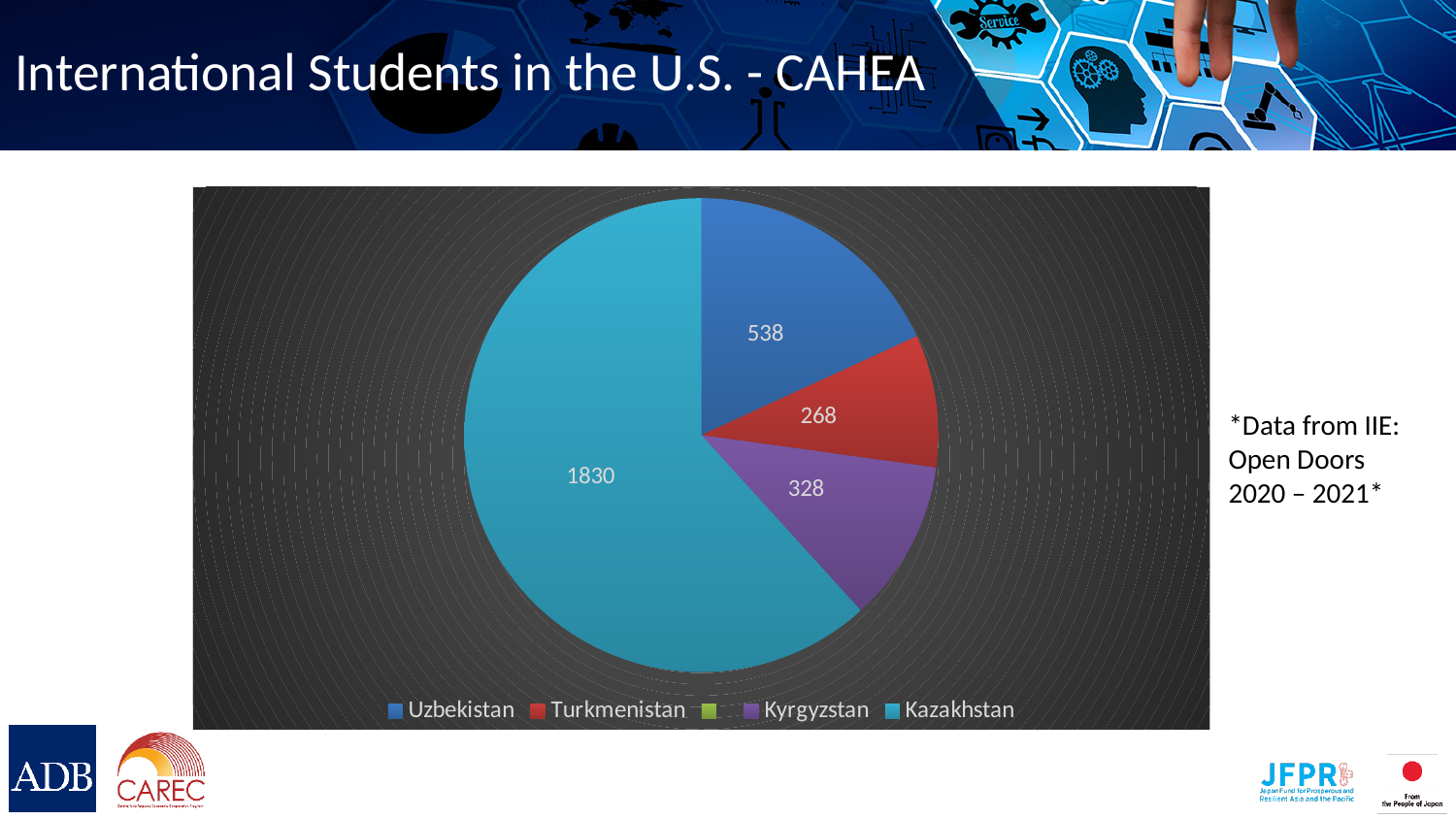
Which country has the largest slice of the pie chart? Kazakhstan What is the difference between the values for Kazakhstan and Uzbekistan? 1292 What is the value shown for Kazakhstan in the pie chart? 1830 What is the value shown for Turkmenistan in the pie chart? 268 What kind of chart is shown on the slide? Pie chart Which is larger, the value for Uzbekistan or the value for Kyrgyzstan? Uzbekistan What is the total of all the values shown on the pie chart? 2964 According to the note on the slide, what is the source of the chart's data? IIE: Open Doors 2020 – 2021 What is the value shown for Uzbekistan in the pie chart? 538 Which country has the smallest slice of the pie chart? Turkmenistan What is the value shown for Kyrgyzstan in the pie chart? 328 What is the difference between the values for Kyrgyzstan and Turkmenistan? 60